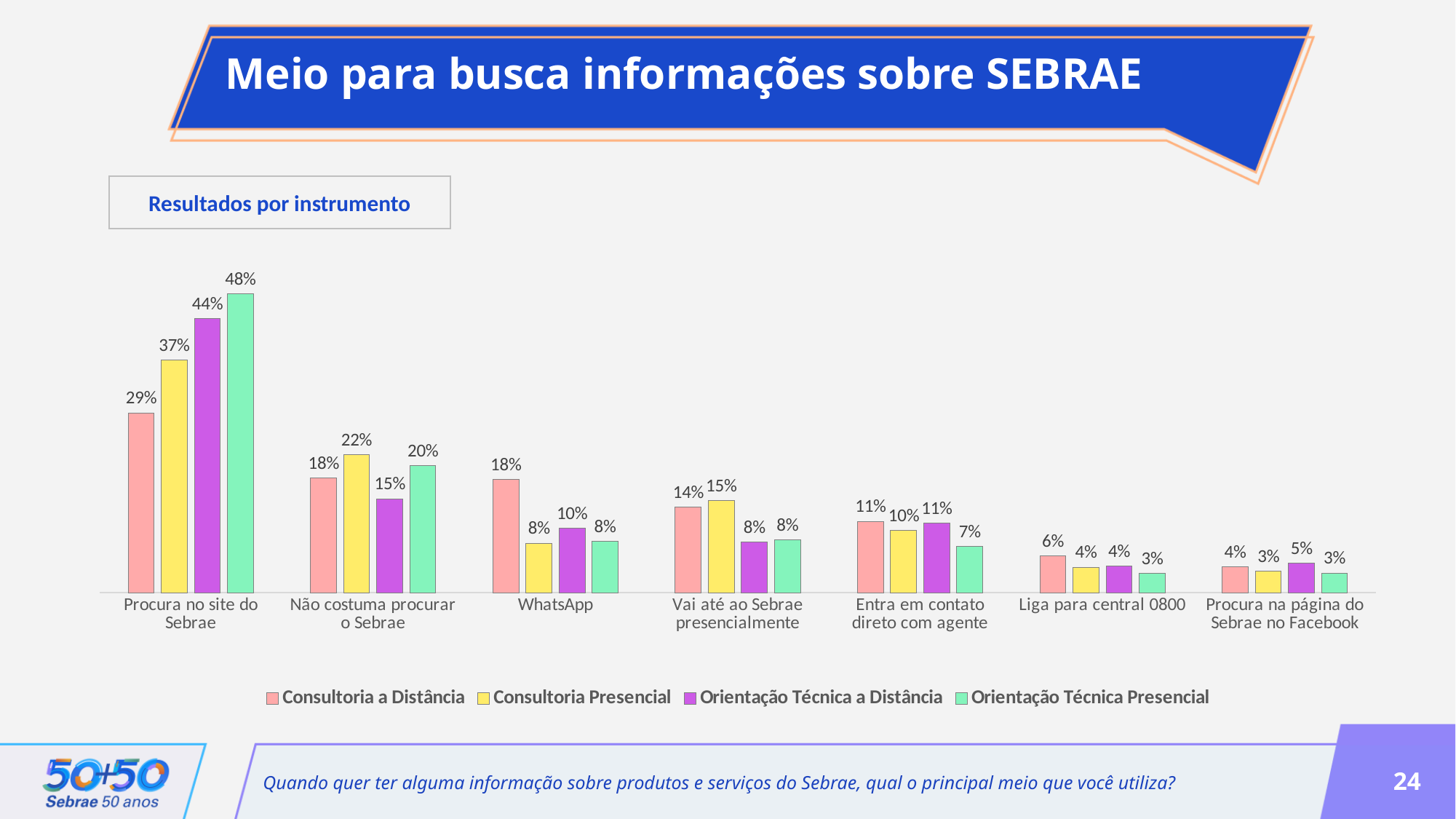
What is the title of the slide? Meio para busca informações sobre SEBRAE What is the value for Consultoria a Distância in the category 'WhatsApp'? 18% How many series does the legend list? 4 Which category has the highest value for Consultoria a Distância? Procura no site do Sebrae Which category has the lowest value for Orientação Técnica a Distância? Liga para central 0800 What is the value for Consultoria Presencial in the category 'Não costuma procurar o Sebrae'? 22% What is the value for Orientação Técnica Presencial in the category 'Procura no site do Sebrae'? 48% What is the difference between Orientação Técnica Presencial and Consultoria a Distância in the category 'Procura no site do Sebrae'? 19% Do the values for Consultoria a Distância generally rise or fall from left to right across the categories? Fall What kind of chart is shown on the slide? Bar chart How many categories are shown on the x axis? 7 In the category 'Vai até ao Sebrae presencialmente', which is larger: Consultoria Presencial or Orientação Técnica a Distância? Consultoria Presencial